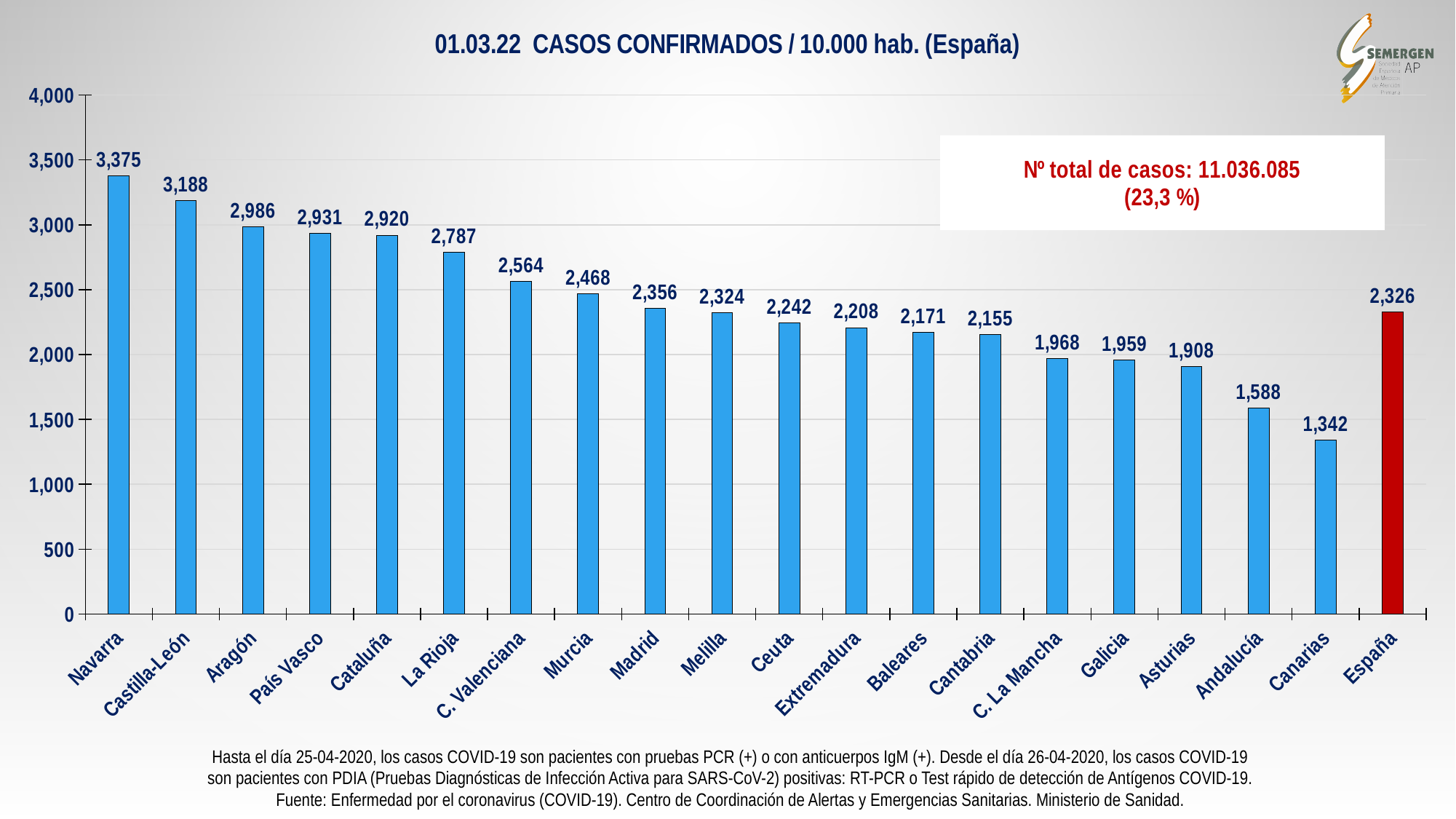
What is the difference between the values for Aragón and Galicia? 1,027 What is the value shown for España (the red bar)? 2,326 What is the value for Navarra? 3,375 What is the total number of cases stated in the box on the chart? 11.036.085 What is the value for Madrid? 2,356 What is the difference between the values for Navarra and Canarias? 2,033 What kind of chart is shown on the slide? bar chart How many bars are plotted in the chart? 20 Which is larger, the value for Murcia or the value for Andalucía? Murcia Which category has the lowest value? Canarias Which category has the highest value? Navarra Is the value for Asturias greater or less than 2,000? less